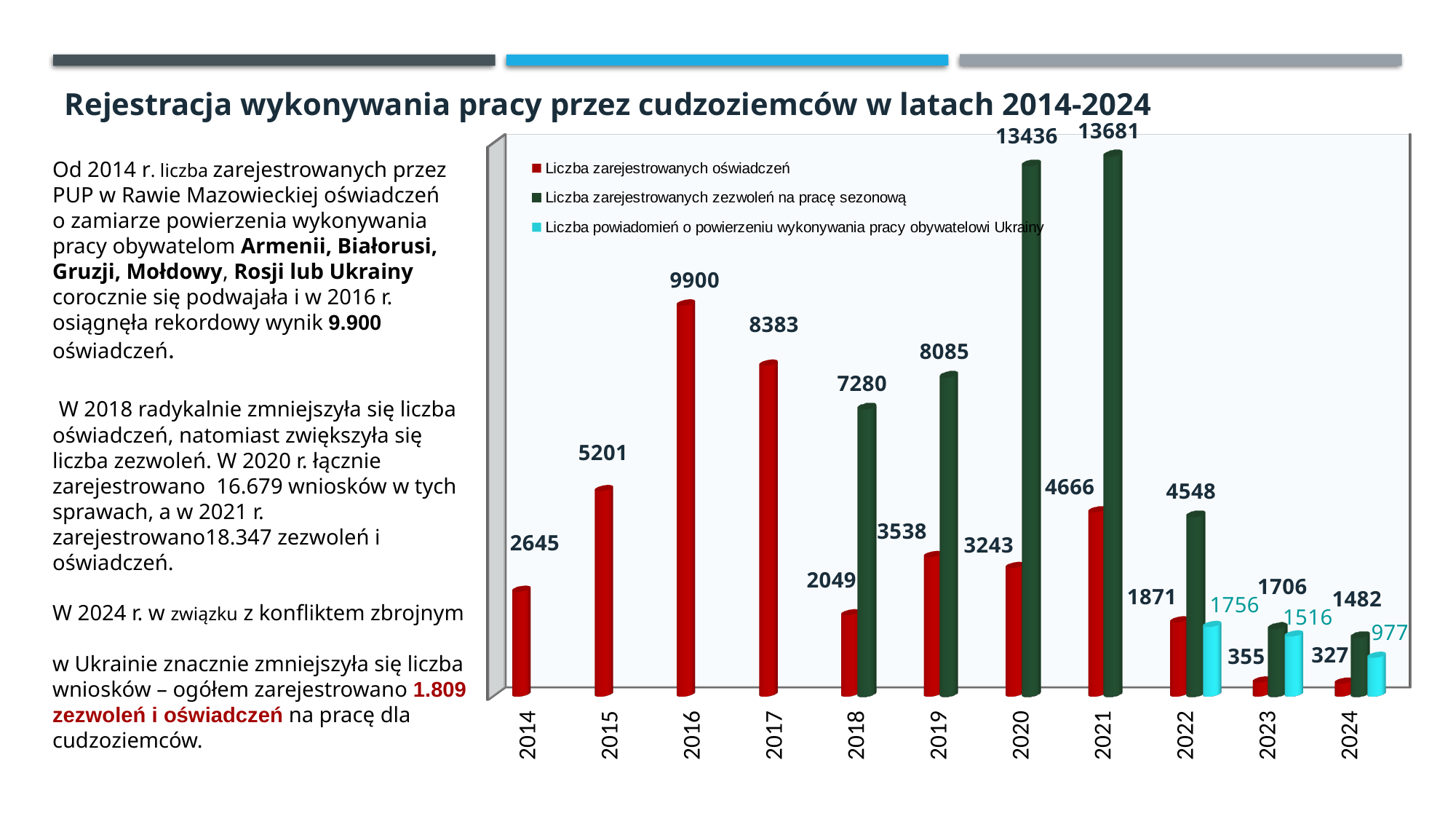
Does 'Liczba zarejestrowanych oświadczeń' rise or fall from 2016 to 2018? fall What is the value of 'Liczba zarejestrowanych oświadczeń' for 2016? 9900 In which year is 'Liczba zarejestrowanych oświadczeń' highest? 2016 What is the combined total of 'Liczba zarejestrowanych oświadczeń' and 'Liczba zarejestrowanych zezwoleń na pracę sezonową' for 2024? 1809 What is the value of 'Liczba zarejestrowanych zezwoleń na pracę sezonową' for 2021? 13681 What is the difference between 'Liczba zarejestrowanych zezwoleń na pracę sezonową' in 2021 and in 2020? 245 What is the value of 'Liczba powiadomień o powierzeniu wykonywania pracy obywatelowi Ukrainy' for 2022? 1756 Which is larger in 2019: 'Liczba zarejestrowanych oświadczeń' or 'Liczba zarejestrowanych zezwoleń na pracę sezonową'? Liczba zarejestrowanych zezwoleń na pracę sezonową How many years are shown on the x axis of the chart? 11 What type of chart is shown on the slide? bar chart In which year is 'Liczba zarejestrowanych oświadczeń' lowest? 2024 How many series does the chart legend list? 3